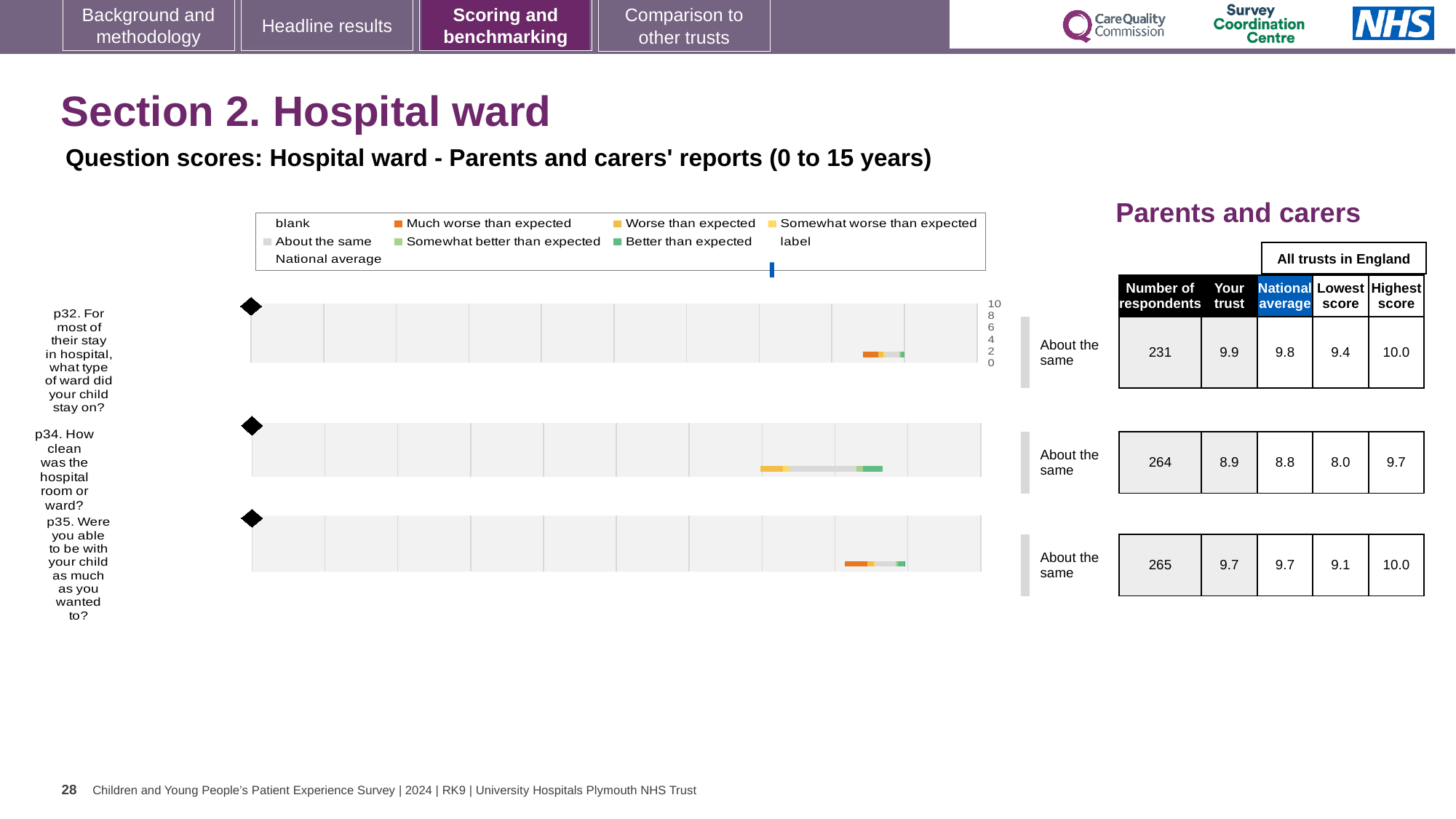
What benchmark category is shown for p35 (were you able to be with your child as much as you wanted to)? About the same What is the highest score across all trusts in England for p34? 9.7 What is the national average score for p34 (how clean was the hospital room or ward)? 8.8 What is the lowest score across all trusts in England for p35 (were you able to be with your child as much as you wanted to)? 9.1 For p34, is the 'Your trust' score or the national average score higher? Your trust How many respondents answered p34 (how clean was the hospital room or ward)? 264 How many questions are plotted in the charts on this slide? 3 Which question has the highest 'Your trust' score? p32 Which question has the lowest 'Your trust' score? p34 What kind of chart is used to show the question scores on this slide? bar chart What is the difference between the highest and lowest scores across all trusts in England for p34? 1.7 What is the 'Your trust' score for p32 (what type of ward did your child stay on)? 9.9